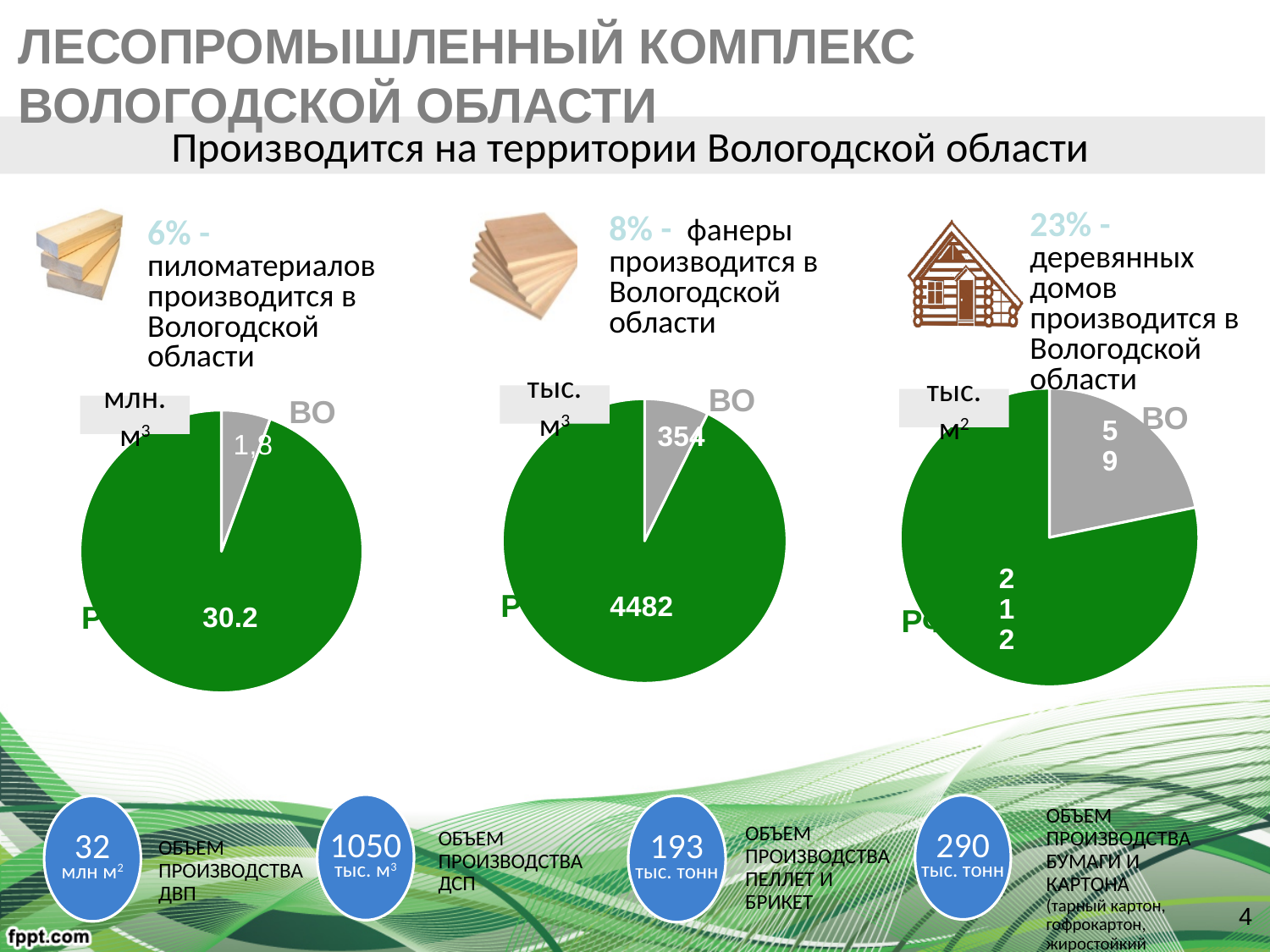
How many pie charts are shown on the slide? 3 In the right pie chart (деревянные дома, тыс. м2), what value is shown for the grey ВО slice? 59 In the middle pie chart, which slice is smaller: the grey ВО slice or the green slice? The grey ВО slice What kind of chart is used for the three charts in the middle of the slide? Pie chart In the left pie chart (пиломатериалы, млн. м3), what value is shown for the grey ВО slice? 1,8 What unit label is shown next to the middle pie chart (фанера)? тыс. м3 In the middle pie chart (фанера, тыс. м3), what value is shown for the grey ВО slice? 354 In the middle pie chart (фанера, тыс. м3), what value is shown on the green slice? 4482 In the left pie chart, which slice is larger: the grey ВО slice or the green slice? The green slice How many slices does each pie chart on the slide have? 2 What colour is the ВО slice in each pie chart? Grey In the left pie chart (пиломатериалы, млн. м3), what value is shown on the green slice? 30.2